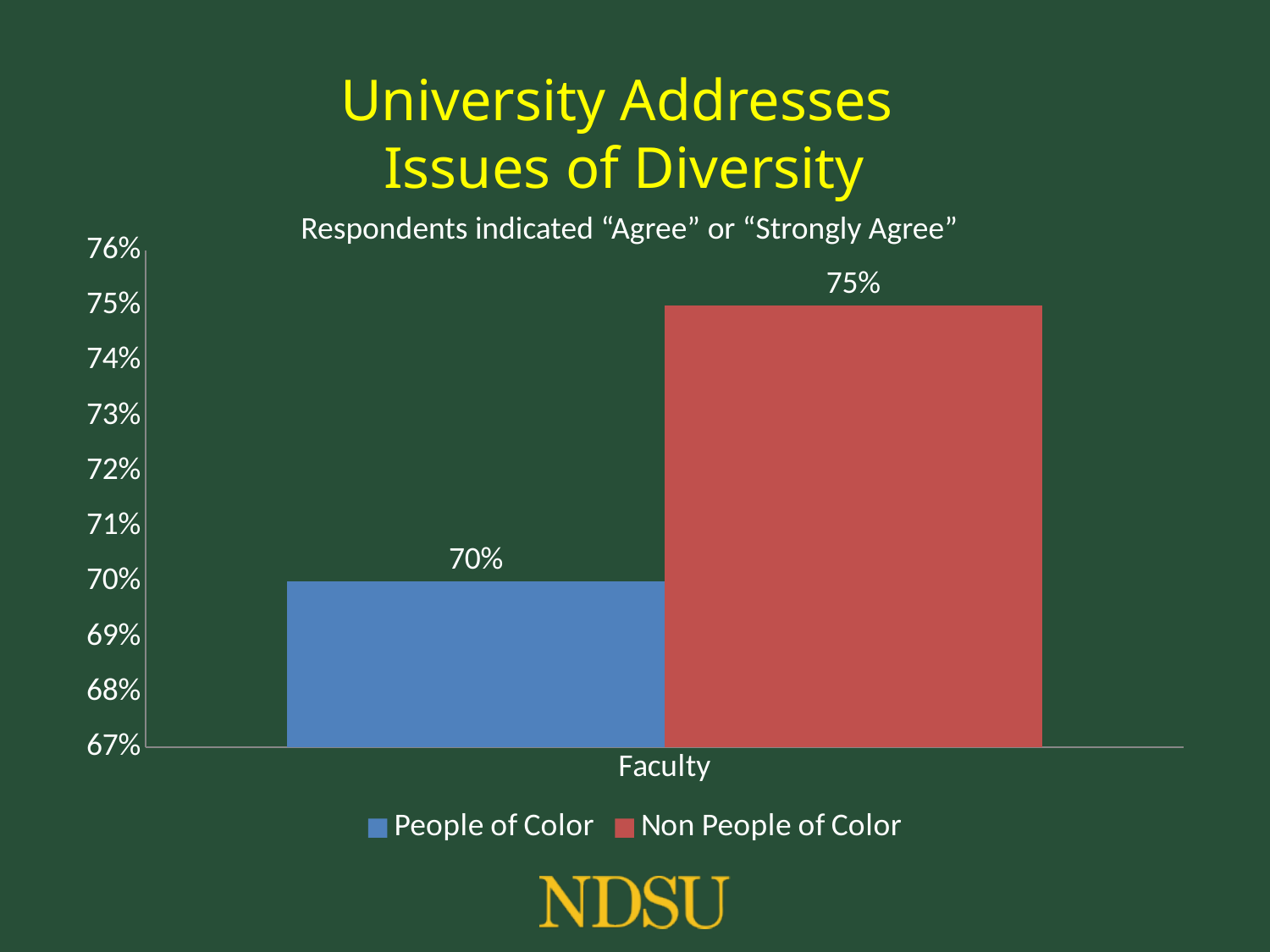
Is the value for Non People of Color greater or less than 72%? greater How many series does the legend list? 2 Which series has the lower value for Faculty? People of Color What kind of chart is shown on the slide? bar chart How many categories are shown on the x axis? 1 Is the value for People of Color larger or smaller than the value for Non People of Color? smaller Which series has the higher value for Faculty? Non People of Color What colour is the bar for Non People of Color? red What percentage of People of Color faculty indicated "Agree" or "Strongly Agree"? 70% What is the title of the chart? University Addresses Issues of Diversity What percentage of Non People of Color faculty indicated "Agree" or "Strongly Agree"? 75% What is the difference between the Non People of Color and People of Color values? 5%